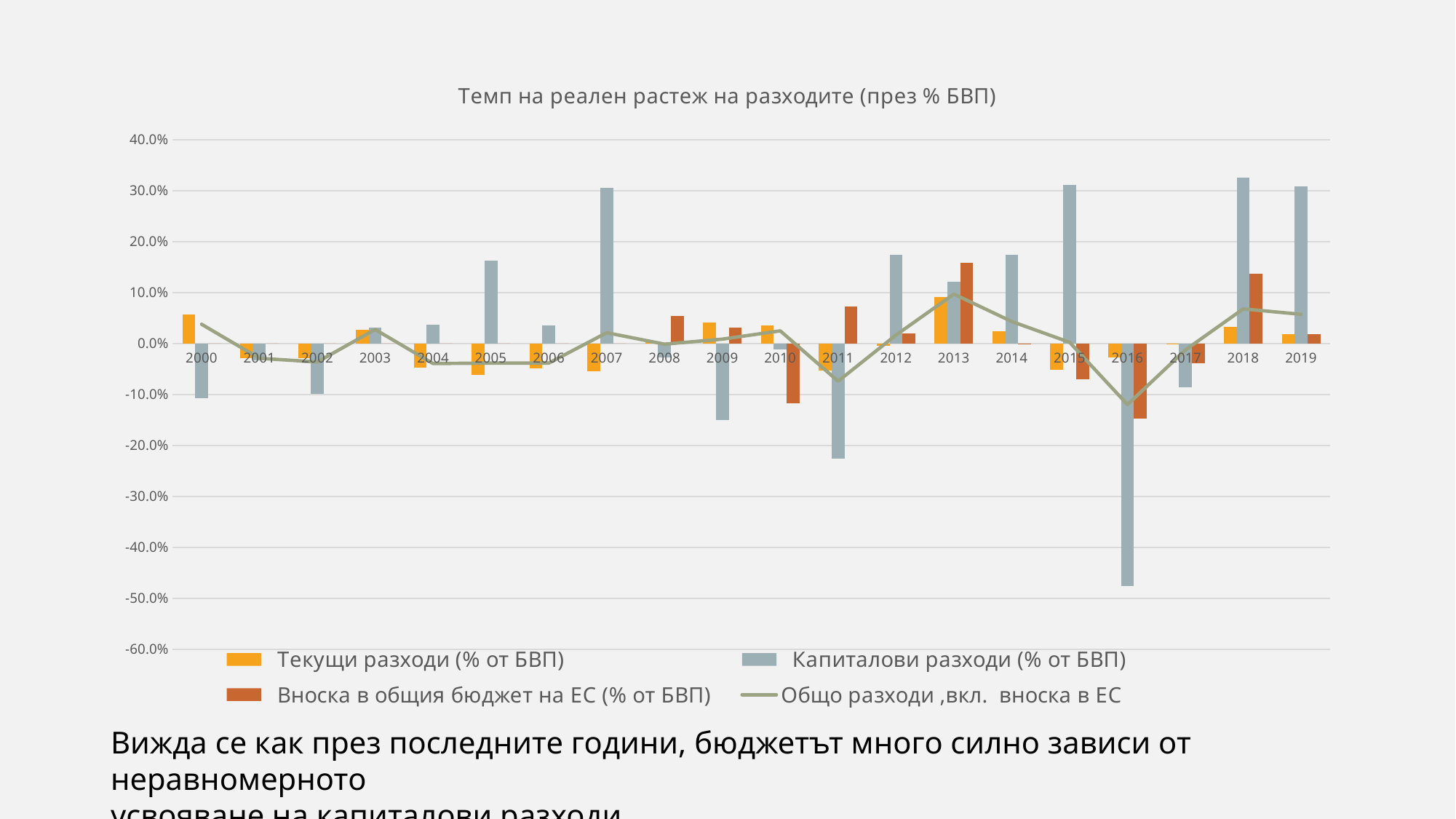
How many years are shown on the x axis? 20 In which year is the value for Вноска в общия бюджет на ЕС (% от БВП) highest? 2013 In which year does the line Общо разходи ,вкл. вноска в ЕС reach its lowest point? 2016 Is the value for Капиталови разходи (% от БВП) in 2011 greater or less than -20.0%? less Is the value for Вноска в общия бюджет на ЕС (% от БВП) in 2013 greater or less than 10.0%? greater In which year is the value for Капиталови разходи (% от БВП) lowest? 2016 How many series does the legend list? 4 In which year is the value for Текущи разходи (% от БВП) highest? 2013 What is the title of the chart? Темп на реален растеж на разходите (през % БВП) Is the value for Капиталови разходи (% от БВП) in 2016 greater or less than -40.0%? less Which series is drawn as a line rather than bars? Общо разходи ,вкл. вноска в ЕС Which is larger, the value for Капиталови разходи (% от БВП) in 2011 or in 2016? 2011